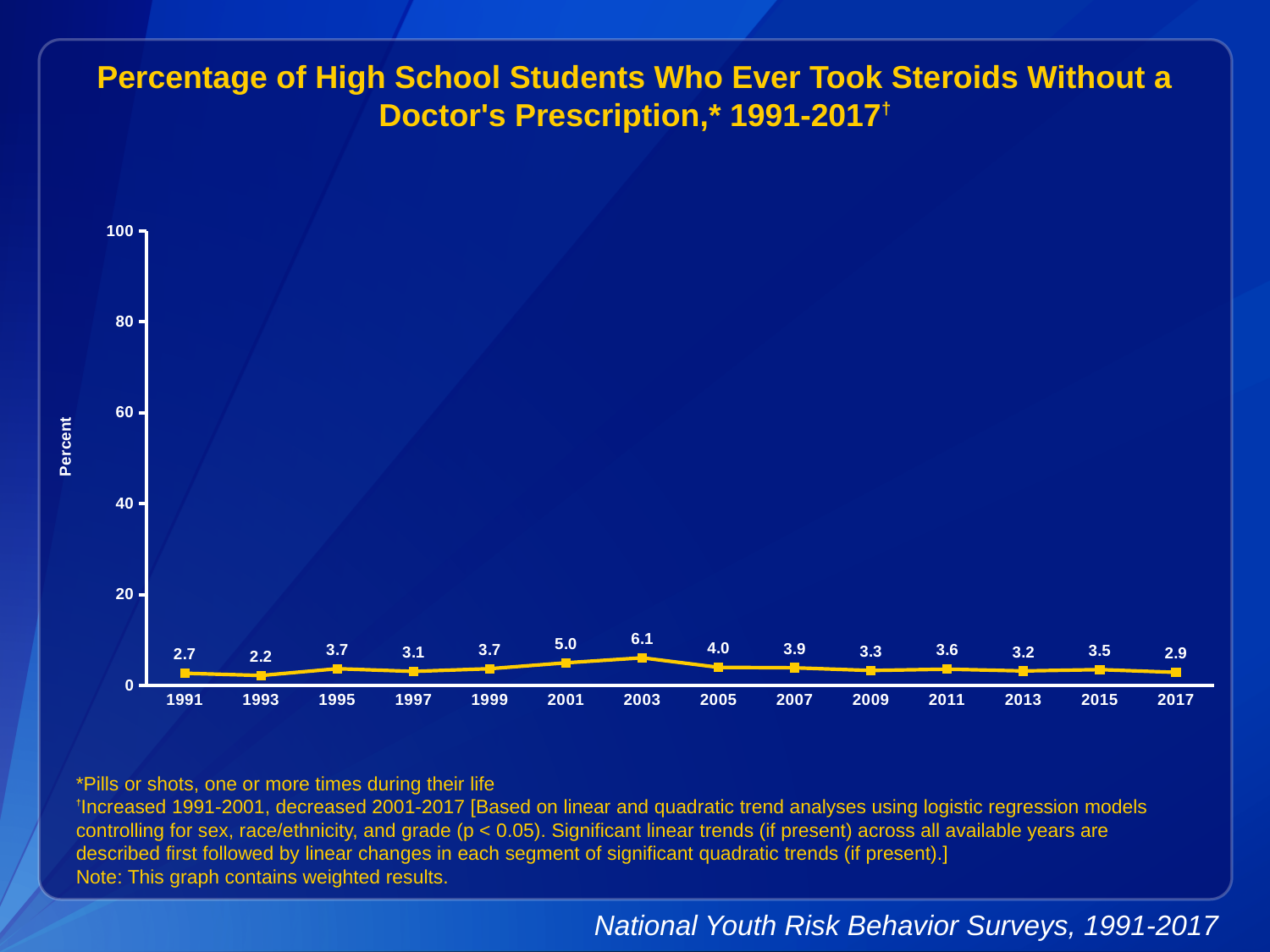
How many years are plotted on the x axis? 14 Do the values rise or fall from 2003 to 2017? fall Which year has the highest percentage? 2003 What is the label on the y axis? Percent Which year has a larger value, 2001 or 2005? 2001 What is the value plotted for 2017? 2.9 What percentage of high school students had ever taken steroids without a doctor's prescription in 2003? 6.1 What is the difference between the 2003 value and the 1993 value? 3.9 Which year has the lowest percentage? 1993 What kind of chart is shown on the slide? line chart Is the value for 2003 greater or less than 20? less What is the value plotted for 1991? 2.7